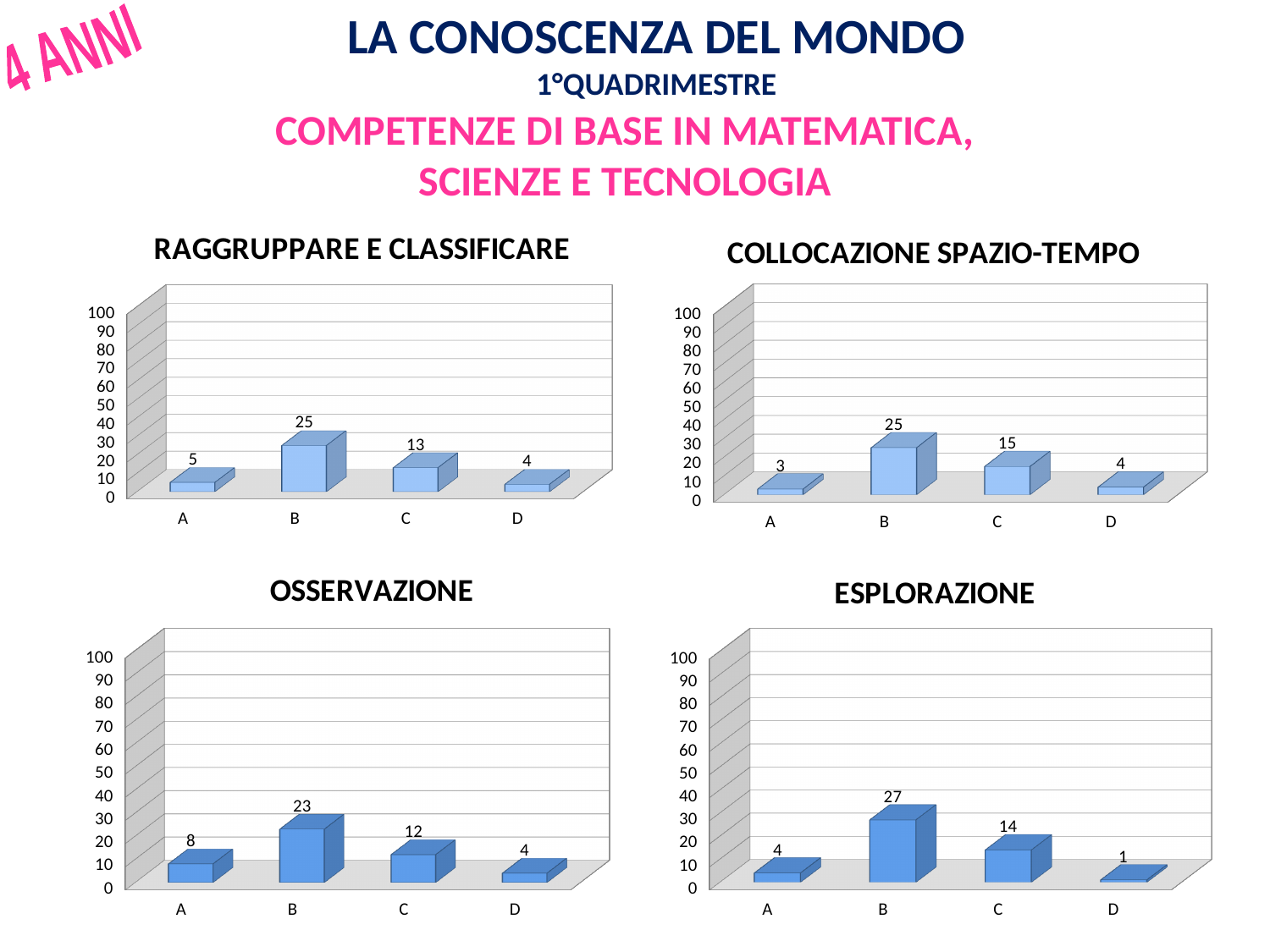
In the ESPLORAZIONE chart, which category has the lowest value? D In the OSSERVAZIONE chart, what is the value for C? 12 In the ESPLORAZIONE chart, which category has the highest value? B In the RAGGRUPPARE E CLASSIFICARE chart, what is the value for B? 25 How many charts are shown on the slide? 4 How many categories are shown in the ESPLORAZIONE chart? 4 In the RAGGRUPPARE E CLASSIFICARE chart, what is the difference between the values for B and C? 12 In the COLLOCAZIONE SPAZIO-TEMPO chart, is the value for B greater or less than 20? greater In the COLLOCAZIONE SPAZIO-TEMPO chart, what is the value for A? 3 In the OSSERVAZIONE chart, which is larger, the value for A or the value for D? A What kind of chart is the OSSERVAZIONE chart? bar chart In the ESPLORAZIONE chart, what is the difference between the values for B and A? 23